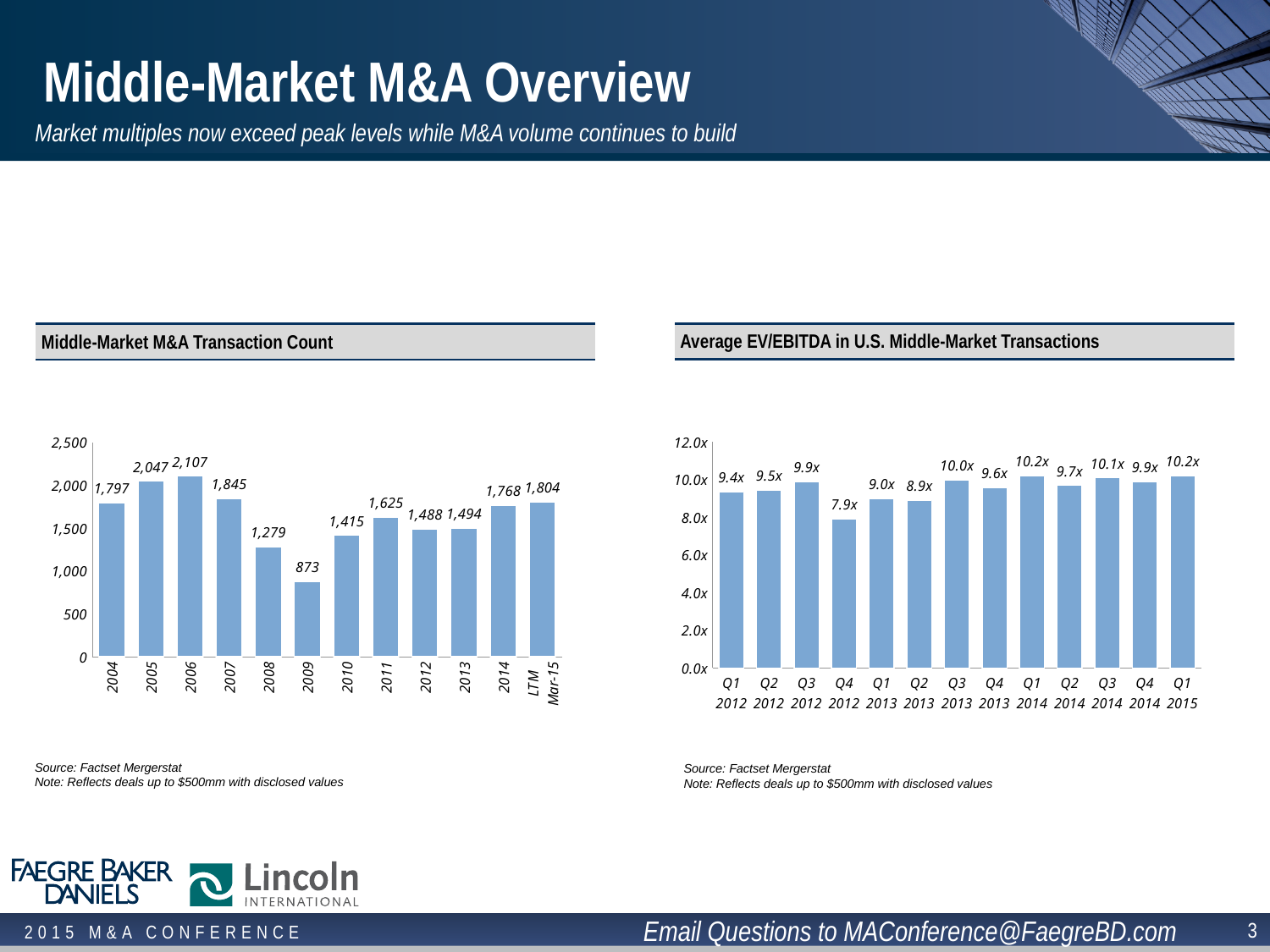
In the Average EV/EBITDA in U.S. Middle-Market Transactions chart, how many quarters are plotted? 13 In the Average EV/EBITDA in U.S. Middle-Market Transactions chart, which quarter has the lowest multiple? Q4 2012 What type of chart is the Average EV/EBITDA in U.S. Middle-Market Transactions chart? Bar chart In the Middle-Market M&A Transaction Count chart, what is the difference between the 2006 and 2009 values? 1,234 In the Middle-Market M&A Transaction Count chart, which year has the highest transaction count? 2006 In the Middle-Market M&A Transaction Count chart, what is the value for LTM Mar-15? 1,804 In the Middle-Market M&A Transaction Count chart, which is larger, the value for 2012 or the value for 2013? 2013 In the Average EV/EBITDA in U.S. Middle-Market Transactions chart, what is the value for Q4 2012? 7.9x In the Average EV/EBITDA in U.S. Middle-Market Transactions chart, what is the difference between the Q1 2015 and Q1 2012 values? 0.8x In the Middle-Market M&A Transaction Count chart, which year has the lowest transaction count? 2009 In the Middle-Market M&A Transaction Count chart, what is the value for 2009? 873 In the Middle-Market M&A Transaction Count chart, how many bars are plotted? 12